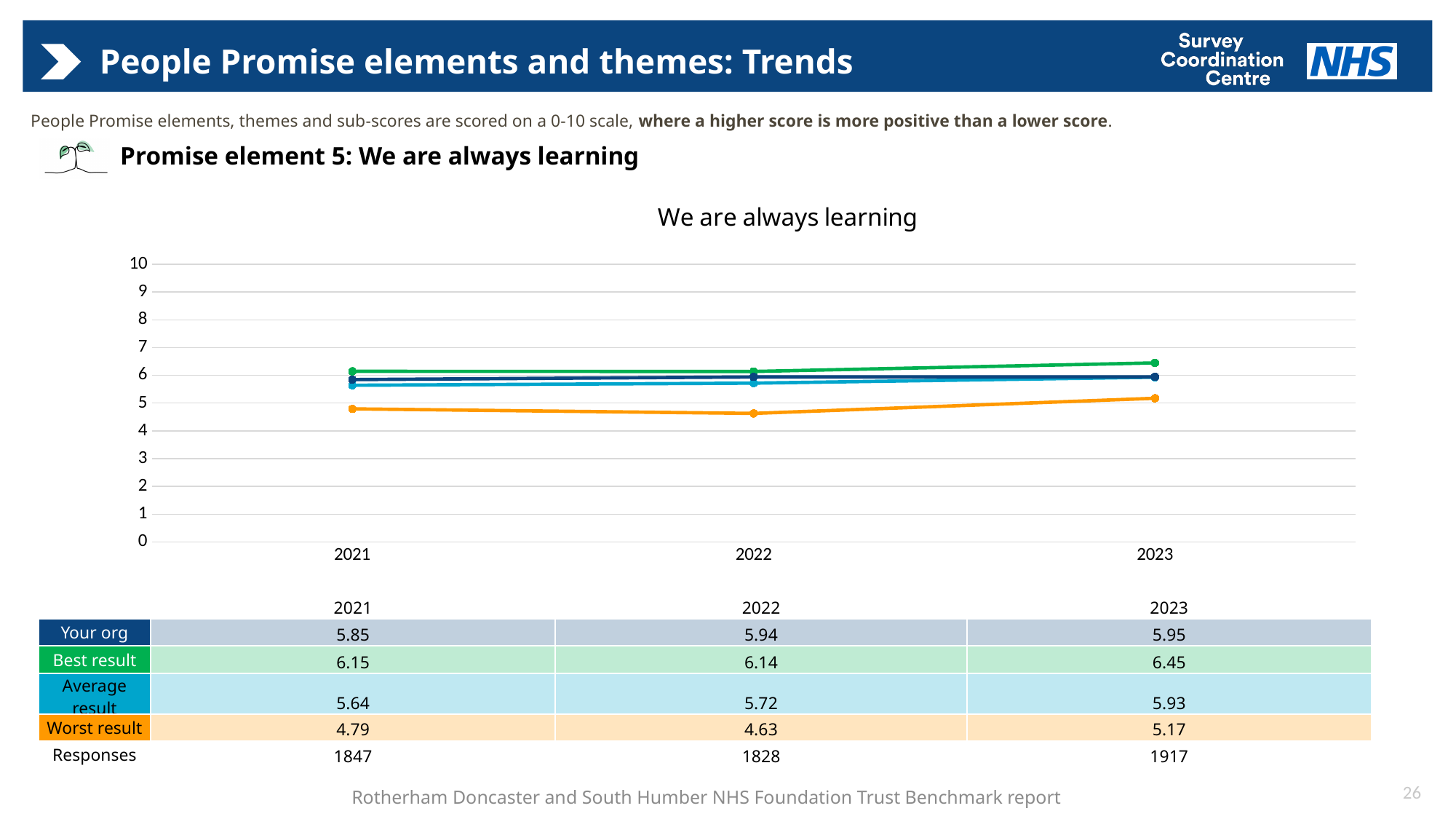
How many years are shown on the x axis of the chart? 3 How many series are plotted in the 'We are always learning' chart? 4 Which is larger in 2021: the 'Your org' score or the 'Average result' score? Your org In which year was the 'Worst result' score lowest? 2022 In which year was the 'Best result' score highest? 2023 What is the difference between the 'Best result' and 'Worst result' scores in 2023? 1.28 What is the 'Average result' score for 2023? 5.93 What is the 'Worst result' score for 2021? 4.79 What is the 'Best result' score for 2023? 6.45 What is the 'Your org' score for 2022 in the 'We are always learning' chart? 5.94 Is the 'Worst result' value for 2022 greater or less than 5? less What kind of chart is used to show the 'We are always learning' trends? Line chart